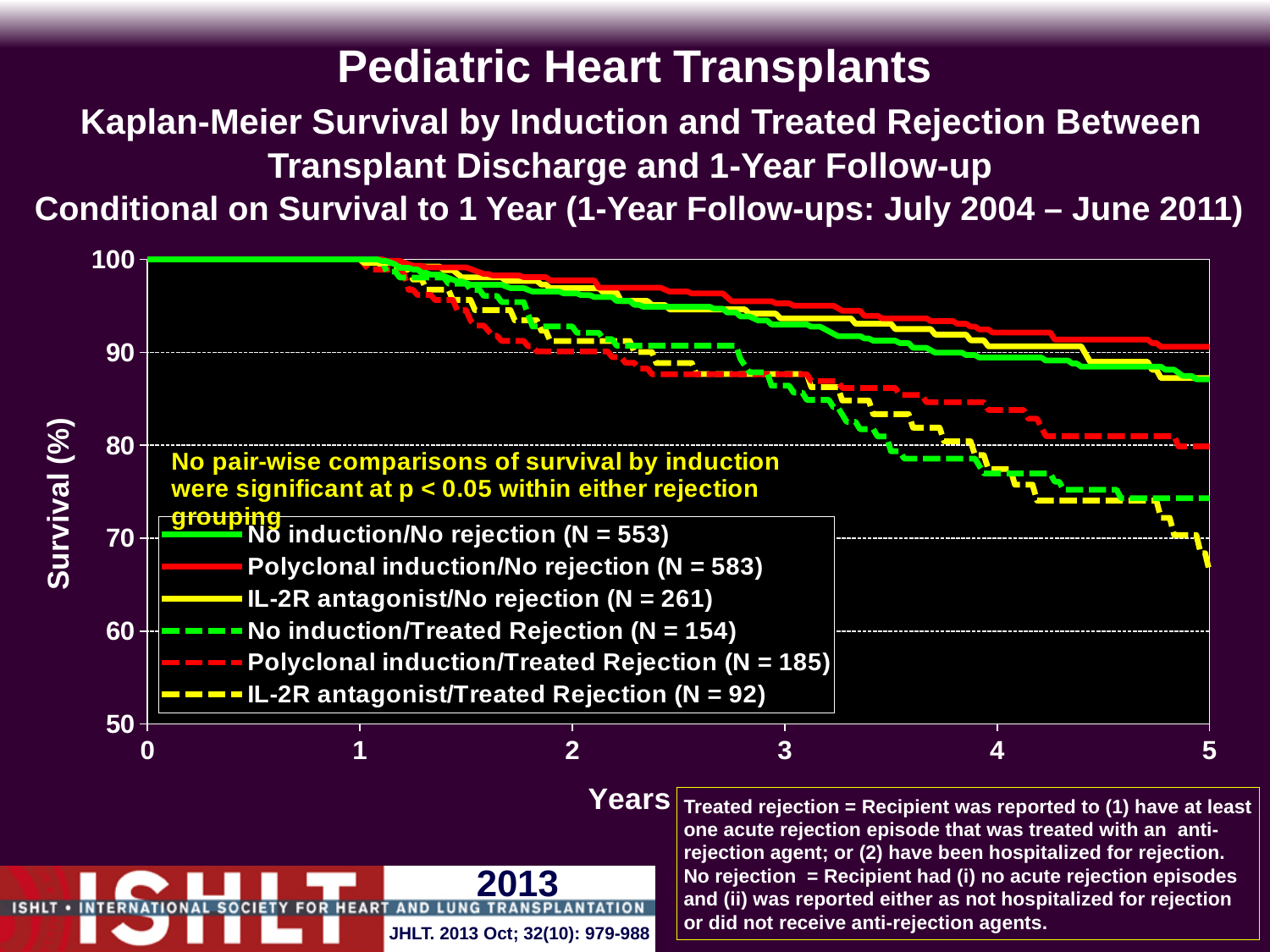
What is the N for the Polyclonal induction/No rejection group shown in the legend? 583 Which group has the highest survival at 5 years? Polyclonal induction/No rejection Do the survival curves rise or fall as years since transplant increase? Fall At 5 years, which has higher survival: No induction/Treated Rejection or IL-2R antagonist/Treated Rejection? No induction/Treated Rejection Is the survival for IL-2R antagonist/Treated Rejection at 5 years greater or less than 70%? less Which group has the lowest survival at 5 years? IL-2R antagonist/Treated Rejection What kind of chart is shown on the slide? Line chart (Kaplan-Meier survival curves) What is the N for the IL-2R antagonist/Treated Rejection group shown in the legend? 92 Is the survival for No induction/No rejection at 5 years greater or less than 90%? less Is the survival for Polyclonal induction/Treated Rejection at 3 years greater or less than 80%? greater How many series does the legend list? 6